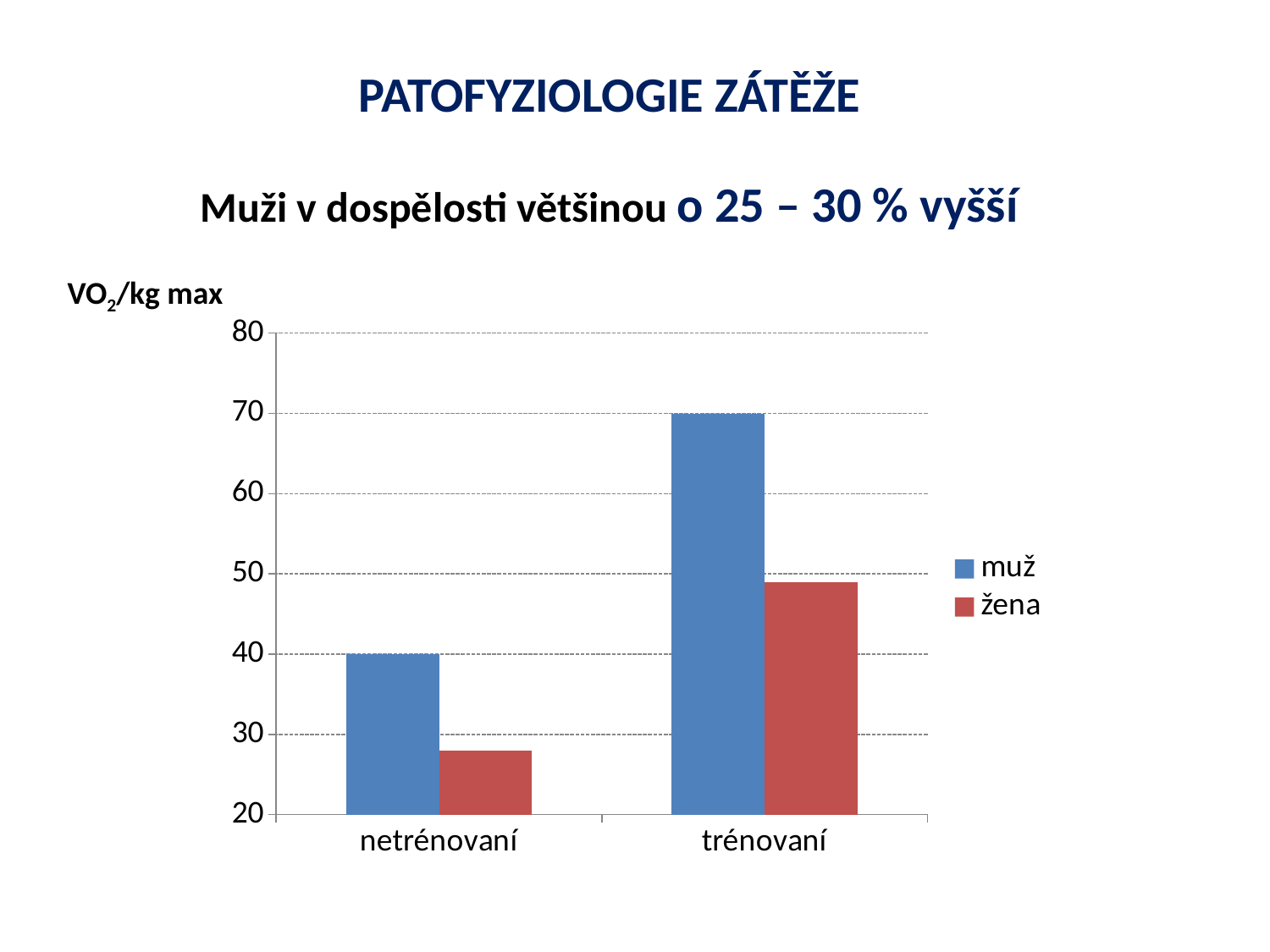
How many categories are shown on the x axis? 2 Which category has the lowest žena value? netrénovaní Which category has the highest muž value? trénovaní Is the value for žena in the netrénovaní category greater or less than 30? less In the trénovaní category, which is larger: the value for muž or the value for žena? muž What is the value for muž in the netrénovaní category? 40 How many series does the legend list? 2 What kind of chart is shown on the slide? bar chart Which series is shown in blue in the legend? muž What is the value for muž in the trénovaní category? 70 What is the difference between the muž value for trénovaní and the muž value for netrénovaní? 30